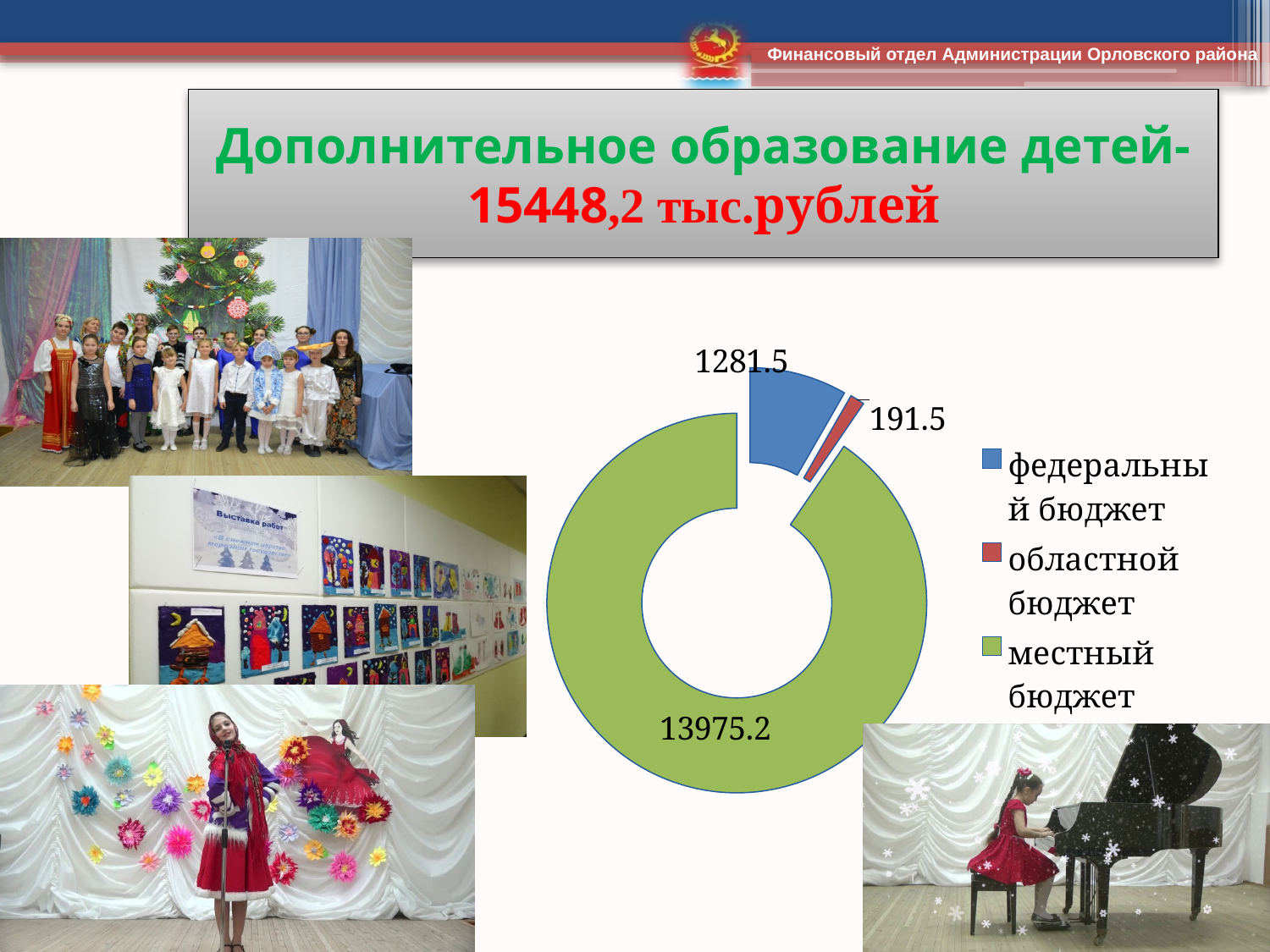
What colour is the местный бюджет segment? green What value is shown for the областной бюджет segment? 191.5 What value is shown for the федеральный бюджет segment? 1281.5 Which budget source has the smallest segment in the chart? областной бюджет What value is shown for the местный бюджет segment? 13975.2 What is the difference between the федеральный бюджет value and the областной бюджет value? 1090.0 How many entries does the legend list? 3 What is the total of all three segments in the chart? 15448.2 What kind of chart is shown on the slide? doughnut chart How many segments does the chart have? 3 Which budget source has the largest segment in the chart? местный бюджет Which is larger, the федеральный бюджет value or the областной бюджет value? федеральный бюджет